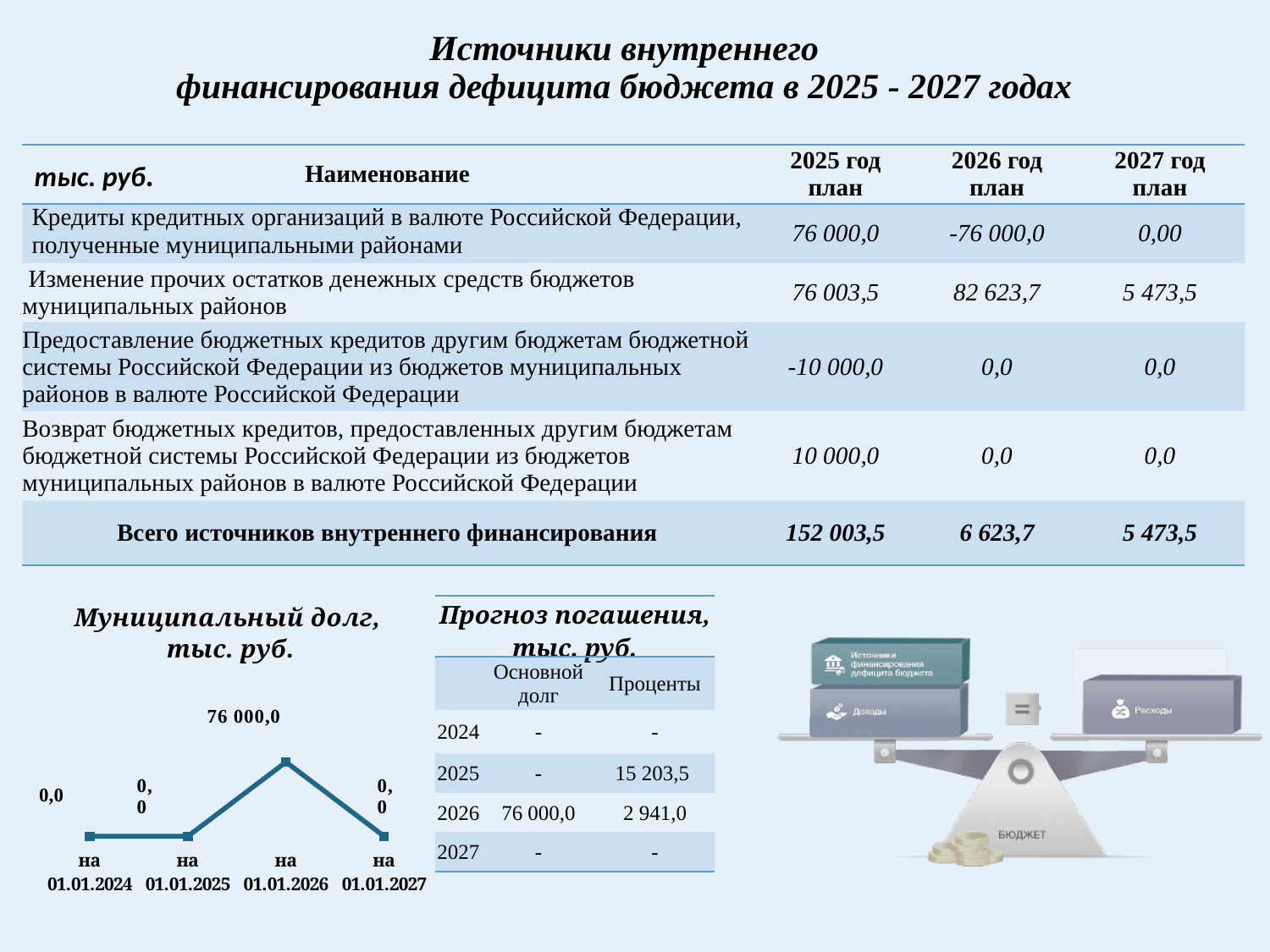
How many data points are plotted in the chart "Муниципальный долг, тыс. руб."? 4 In the chart "Муниципальный долг, тыс. руб.", what is the value for на 01.01.2026? 76 000,0 What is the title of the line chart on the slide? Муниципальный долг, тыс. руб. In the chart "Муниципальный долг, тыс. руб.", what is the value for на 01.01.2024? 0,0 In the chart "Муниципальный долг, тыс. руб.", does the value rise or fall from на 01.01.2025 to на 01.01.2026? rise In the chart "Муниципальный долг, тыс. руб.", which is larger: the value for на 01.01.2026 or the value for на 01.01.2027? на 01.01.2026 In the chart "Муниципальный долг, тыс. руб.", which date has the highest value? на 01.01.2026 In the chart "Муниципальный долг, тыс. руб.", what is the difference between the values for на 01.01.2026 and на 01.01.2025? 76 000,0 In the chart "Муниципальный долг, тыс. руб.", does the value rise or fall from на 01.01.2026 to на 01.01.2027? fall In the chart "Муниципальный долг, тыс. руб.", what is the value for на 01.01.2027? 0,0 In the chart "Муниципальный долг, тыс. руб.", what is the value for на 01.01.2025? 0,0 What type of chart is "Муниципальный долг, тыс. руб."? line chart